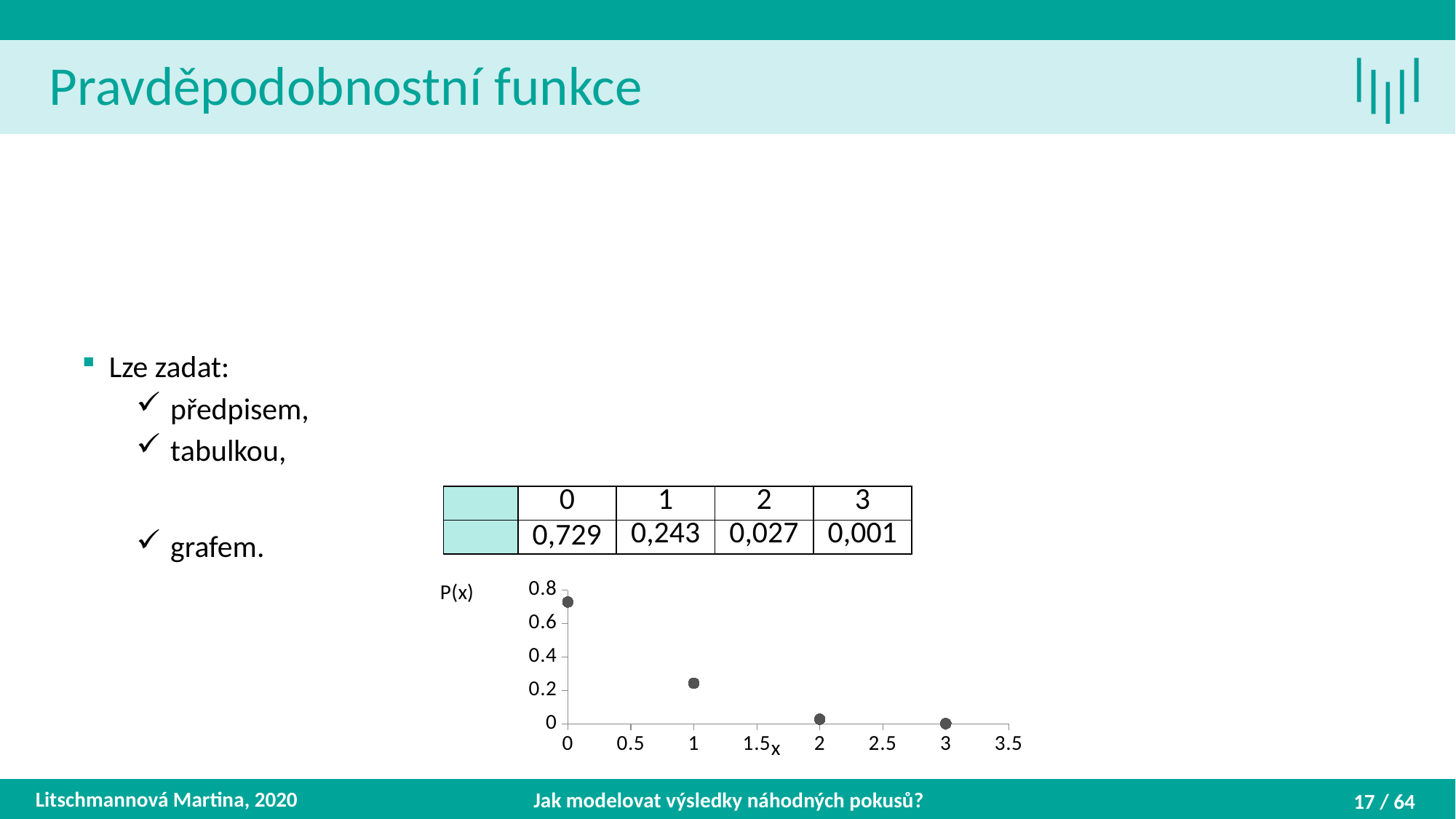
What kind of chart is shown on the slide? scatter chart What label is shown on the vertical axis of the chart? P(x) At which x value is the plotted P(x) lowest? 3 According to the table above the chart, what is the value of P(x) at x = 3? 0,001 At which x value is the plotted P(x) highest? 0 Which plotted value is larger, the one at x = 1 or the one at x = 2? x = 1 According to the table above the chart, what is the value of P(x) at x = 0? 0,729 Is the plotted value at x = 1 greater or less than 0.4? less How many data points are plotted in the chart? 4 Is the plotted value at x = 2 greater or less than 0.2? less Is the plotted value at x = 0 greater or less than 0.6? greater Do the plotted values rise or fall as x increases? fall